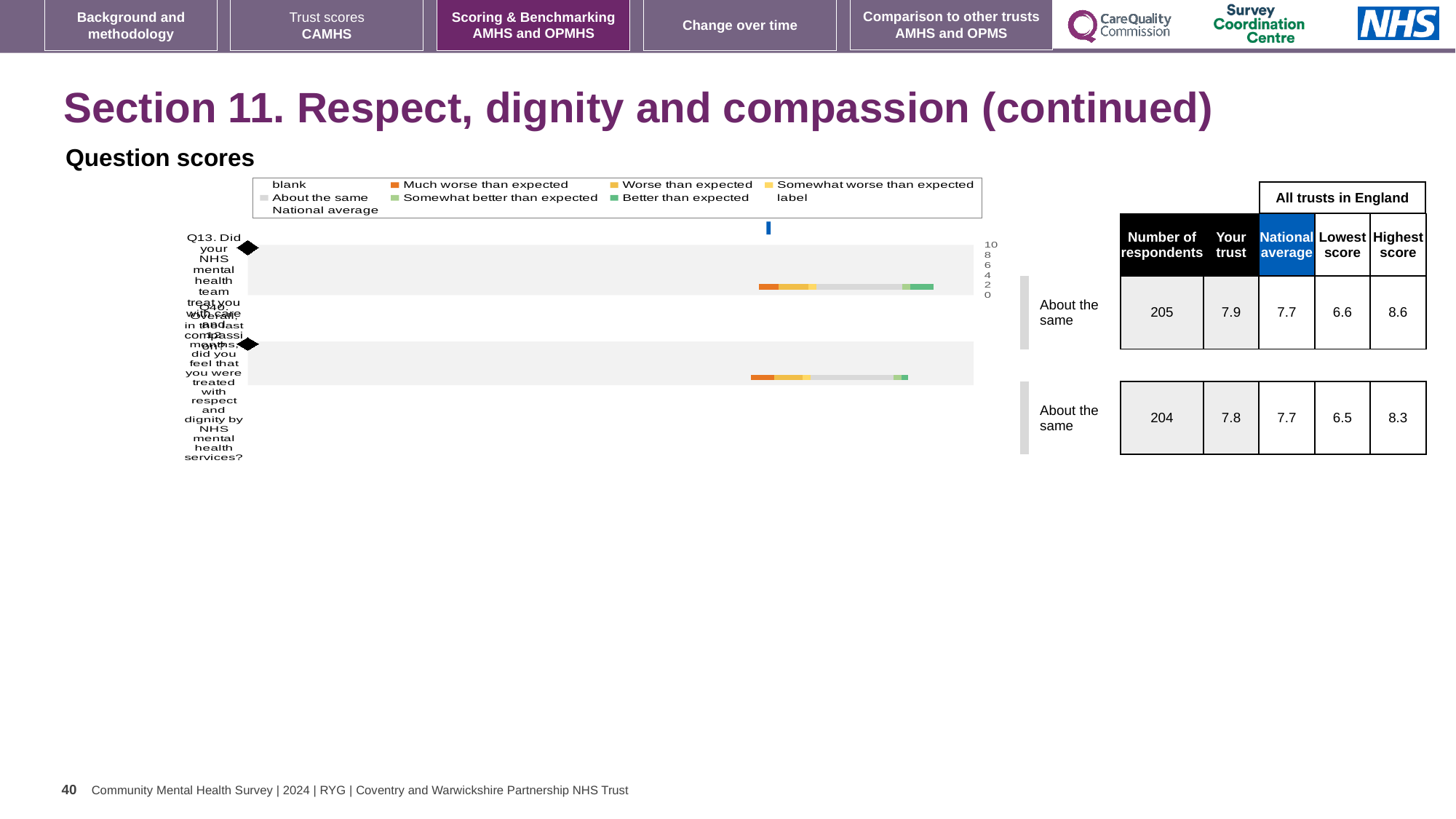
What type of chart is used to show the question scores on this slide? bar chart What is the highest score across all trusts in England for Q13? 8.6 How many questions are plotted in the question scores chart? 2 By how much does the trust's score for Q13 exceed the national average? 0.2 How many respondents answered Q10? 204 What is the difference between the highest and lowest scores for Q13? 2.0 What is the lowest score across all trusts in England for Q10? 6.5 Which question has the higher 'Your trust' score, Q13 or Q10? Q13 What benchmark category is shown for both Q13 and Q10? About the same What is the national average score for Q13? 7.7